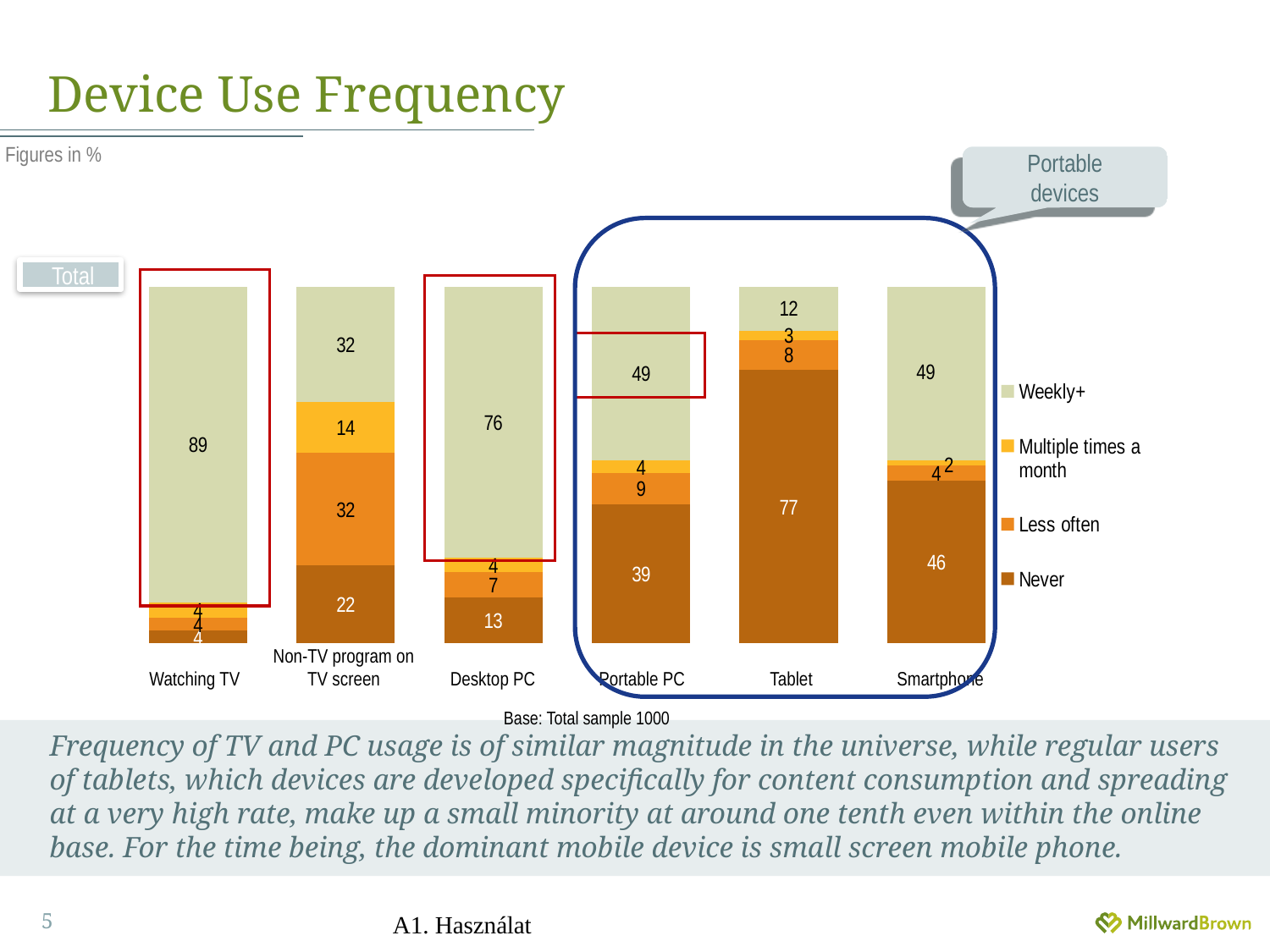
What is the Weekly+ value for Watching TV? 89 What is the Never value for Portable PC? 39 Which device has the highest Weekly+ value? Watching TV What is the Never value for Tablet? 77 What kind of chart is shown on the slide? Stacked bar chart Which has a larger Never value, Tablet or Smartphone? Tablet What is the Multiple times a month value for Non-TV program on TV screen? 14 How many device categories are shown on the x axis? 6 Which device has the lowest Weekly+ value? Tablet What is the Weekly+ value for Desktop PC? 76 How many series does the legend list? 4 What is the difference between the Weekly+ values for Desktop PC and Portable PC? 27